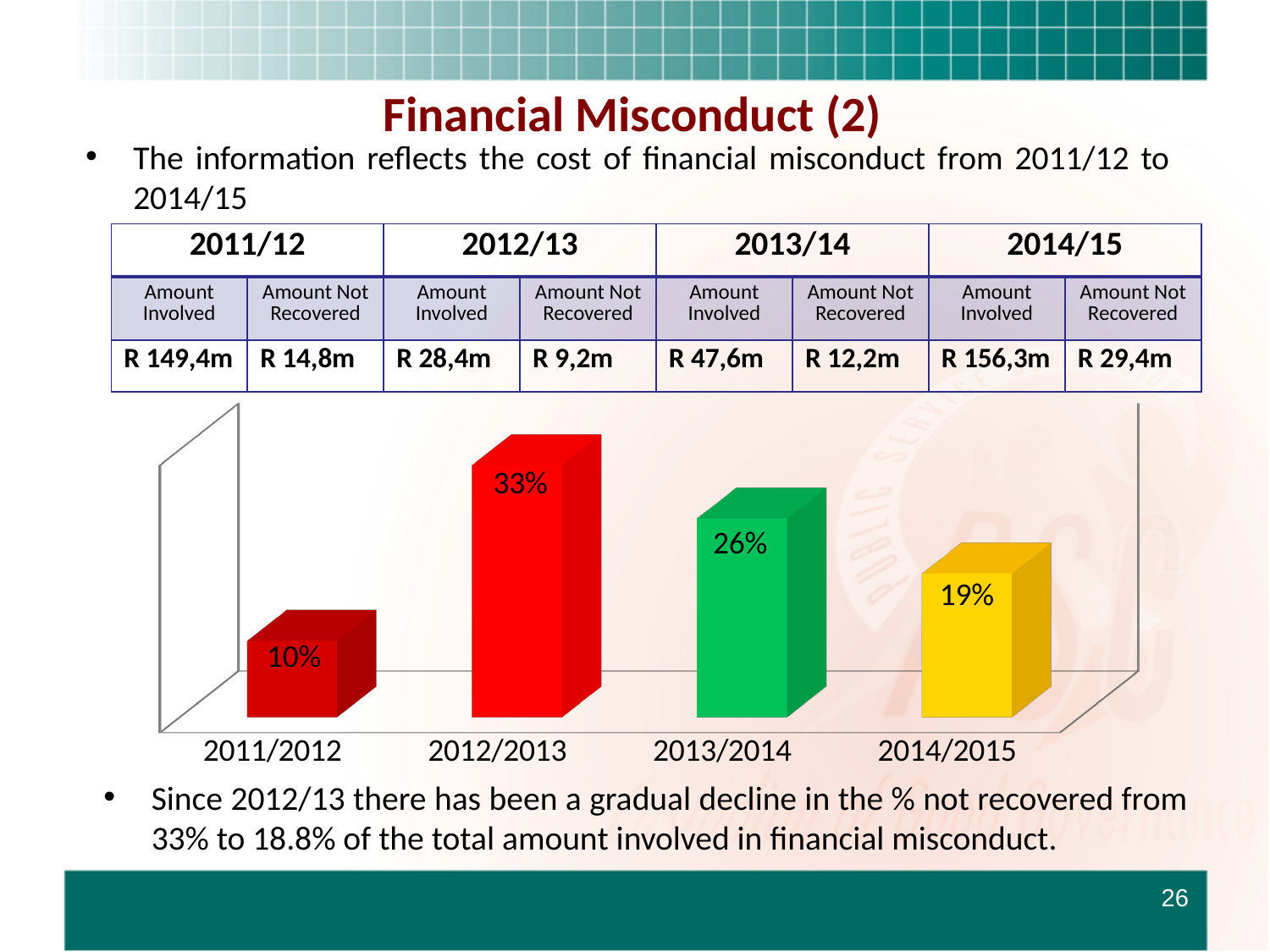
What is the difference between the values for 2013/2014 and 2011/2012 in the bar chart? 16% How many bars are shown in the chart? 4 Which year has the highest value in the bar chart? 2012/2013 Which year has the lowest value in the bar chart? 2011/2012 Do the values in the bar chart rise or fall from 2012/2013 to 2014/2015? Fall Which is larger in the bar chart, the value for 2013/2014 or the value for 2014/2015? 2013/2014 What is the value shown for 2012/2013 in the bar chart? 33% What is the value shown for 2013/2014 in the bar chart? 26% What is the difference between the values for 2012/2013 and 2014/2015 in the bar chart? 14% What kind of chart is shown on the slide? Bar chart What is the value shown for 2011/2012 in the bar chart? 10% What is the value shown for 2014/2015 in the bar chart? 19%